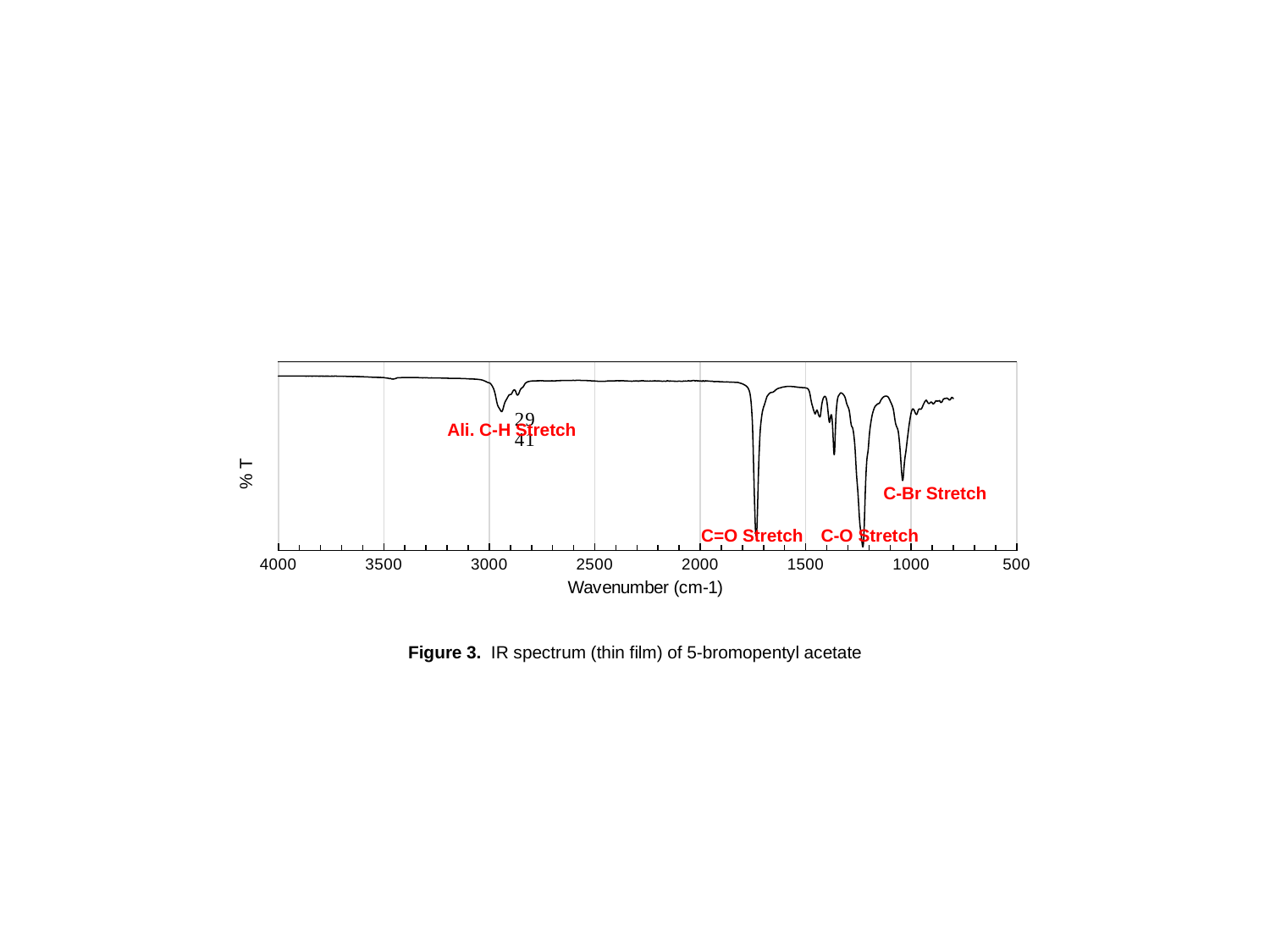
Is the wavenumber of the peak labeled C-Br Stretch greater or less than 1500? less What is the label of the y axis of the IR spectrum? % T Which peak reaches a lower % T, the one labeled C=O Stretch or the one labeled C-Br Stretch? C=O Stretch How many stretch annotations are labeled on the IR spectrum? 4 How many labeled x-axis tick values are shown on the IR spectrum? 8 Do the x-axis tick values increase or decrease from left to right on the IR spectrum? decrease Which peak reaches a lower % T, the one labeled Ali. C-H Stretch or the one labeled C-O Stretch? C-O Stretch What kind of chart is shown on the slide? line chart Is the wavenumber of the peak labeled Ali. C-H Stretch greater or less than 2500? greater What is the label of the x axis of the IR spectrum? Wavenumber (cm-1) Is the wavenumber of the peak labeled C-O Stretch greater or less than 1500? less